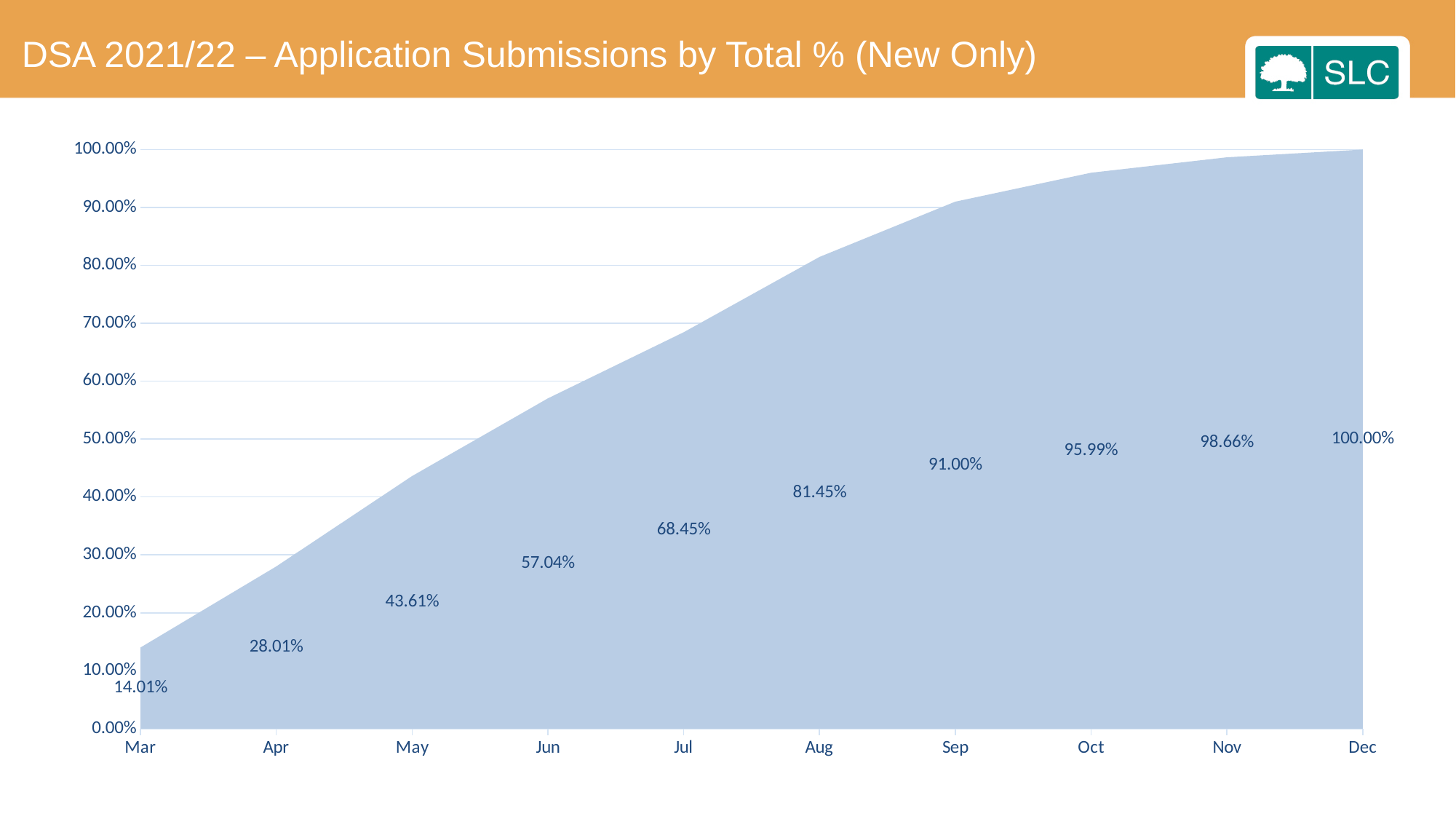
What is the difference between the values for Dec and Nov? 1.34% Is the value for Oct greater or less than 90.00%? greater Which is larger, the value for May or the value for Apr? May Which month has the highest value? Dec What is the value for Sep? 91.00% What is the difference between the values for Aug and Jul? 13.00% Which month has the lowest value? Mar What kind of chart is this? area chart How many months are shown on the x axis? 10 What is the value for Mar? 14.01% Do the values rise or fall from Mar to Dec? rise What is the value for Jun? 57.04%